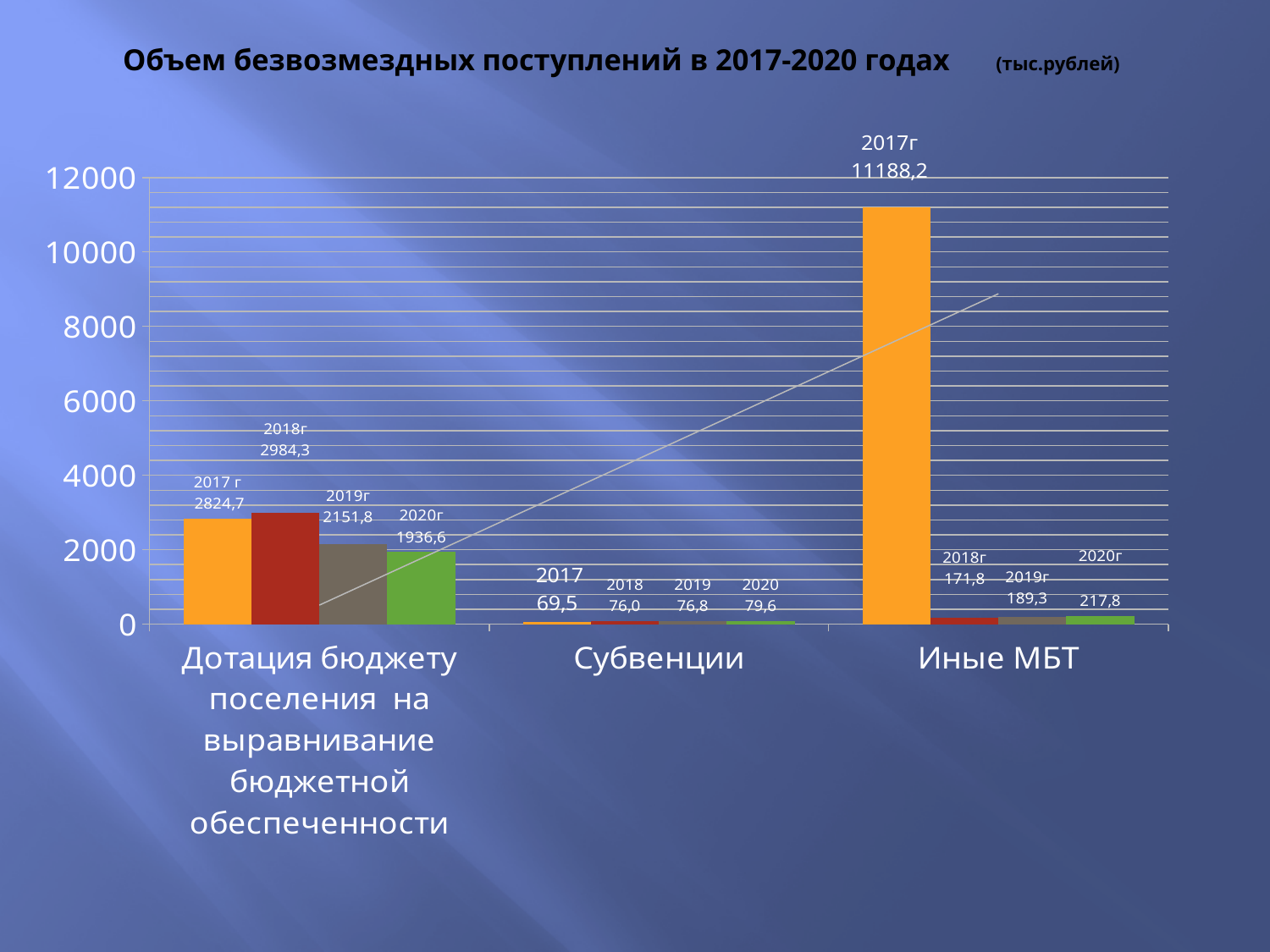
What is the difference between the 2018 and 2020 values in the Дотация бюджету поселения на выравнивание бюджетной обеспеченности category? 1047,7 How many categories are shown on the x axis? 3 Which year has the lowest value in the Субвенции category? 2017 Which is larger: the 2019 value for Субвенции or the 2019 value for Иные МБТ? Иные МБТ What is the value for 2019 in the Иные МБТ category? 189,3 What unit is given in the chart title? тыс.рублей What kind of chart is shown on the slide? bar chart What is the value for 2017 in the Иные МБТ category? 11188,2 Which year has the highest value in the Дотация бюджету поселения на выравнивание бюджетной обеспеченности category? 2018 What is the value for 2018 in the Дотация бюджету поселения на выравнивание бюджетной обеспеченности category? 2984,3 Is the 2017 value for Иные МБТ greater or less than 10000? greater What is the value for 2020 in the Субвенции category? 79,6